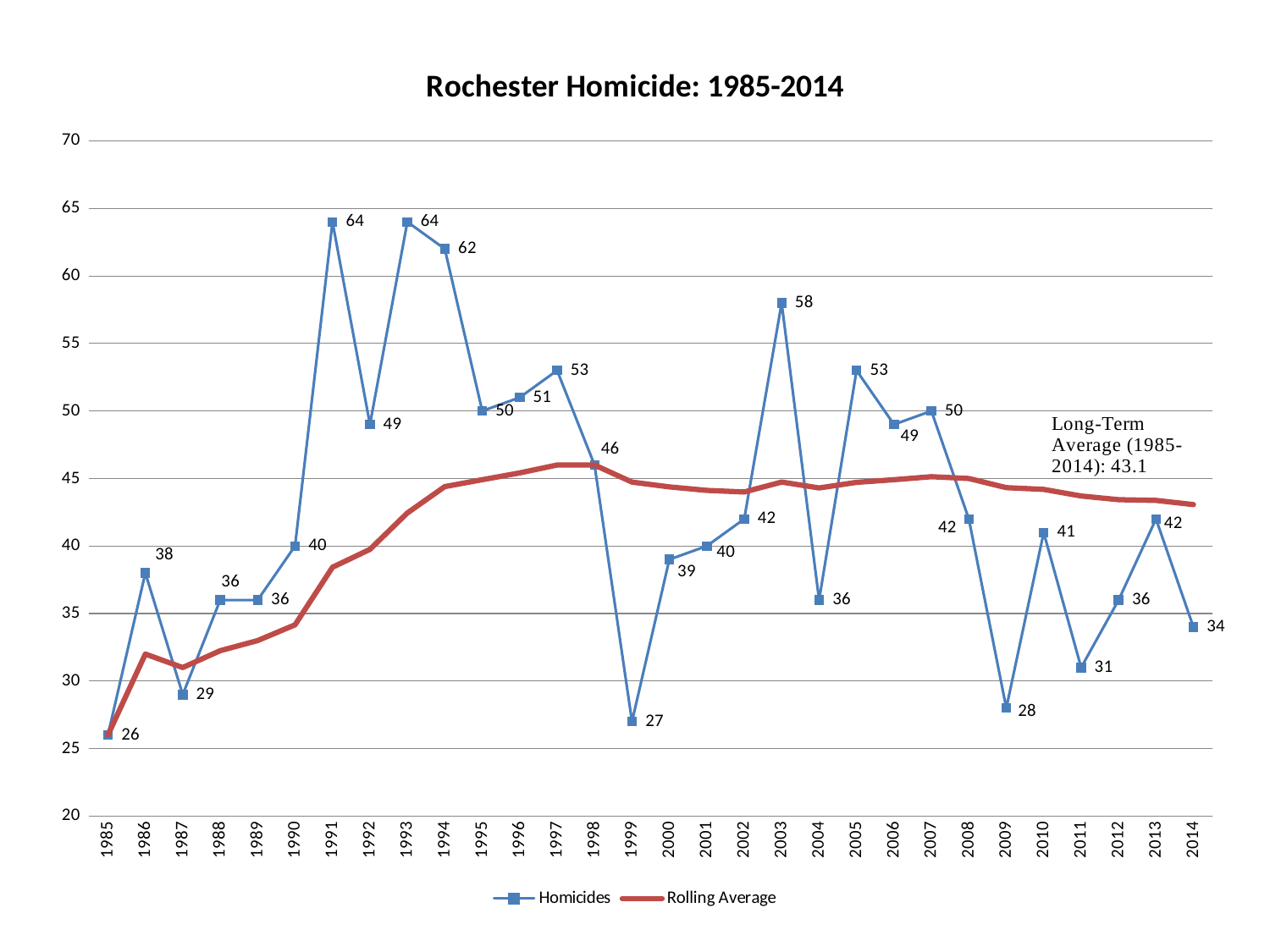
Is the Rolling Average value for 1987 greater or less than 35? less Do the homicide values rise or fall from 2010 to 2011? fall What kind of chart is shown on the slide? line chart Which year had more homicides, 2005 or 2009? 2005 What is the difference between the homicides in 2003 and 2004? 22 What is the Homicides value for 2014? 34 Which year has the lowest number of homicides? 1985 What is the Homicides value for 1999? 27 Is the Rolling Average value for 1997 greater or less than 40? greater How many homicides were recorded in Rochester in 1991? 64 What long-term average (1985-2014) is stated on the chart? 43.1 How many series does the legend list? 2